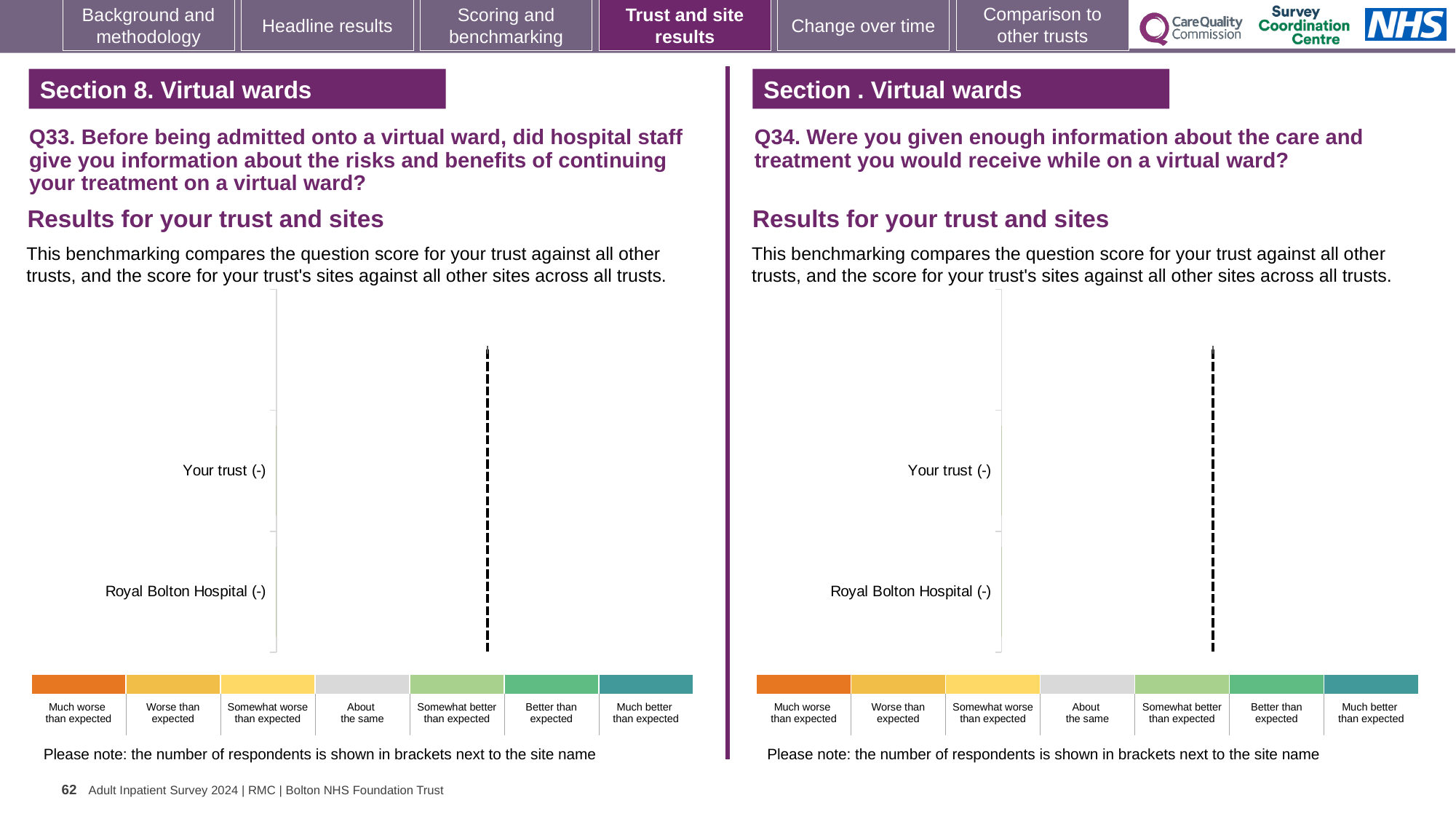
In the colour key below the right chart (Q34), which band is labelled in grey? About the same On the right chart (Q34), how many categories are listed on the vertical axis? 2 What kind of chart is used for the Q34 results on the right? Bar chart On the left chart (Q33), what are the two category labels shown on the vertical axis? Your trust (-) and Royal Bolton Hospital (-) What kind of chart is used for the Q33 results on the left? Bar chart How many benchmark bands does the colour key below the left chart (Q33) list? 7 On the left chart (Q33), what is shown in brackets next to the site name Royal Bolton Hospital? (-) How many benchmark bands does the colour key below the right chart (Q34) list? 7 On the right chart (Q34), what is shown in brackets next to Your trust? (-) On the left chart (Q33), how many categories are listed on the vertical axis? 2